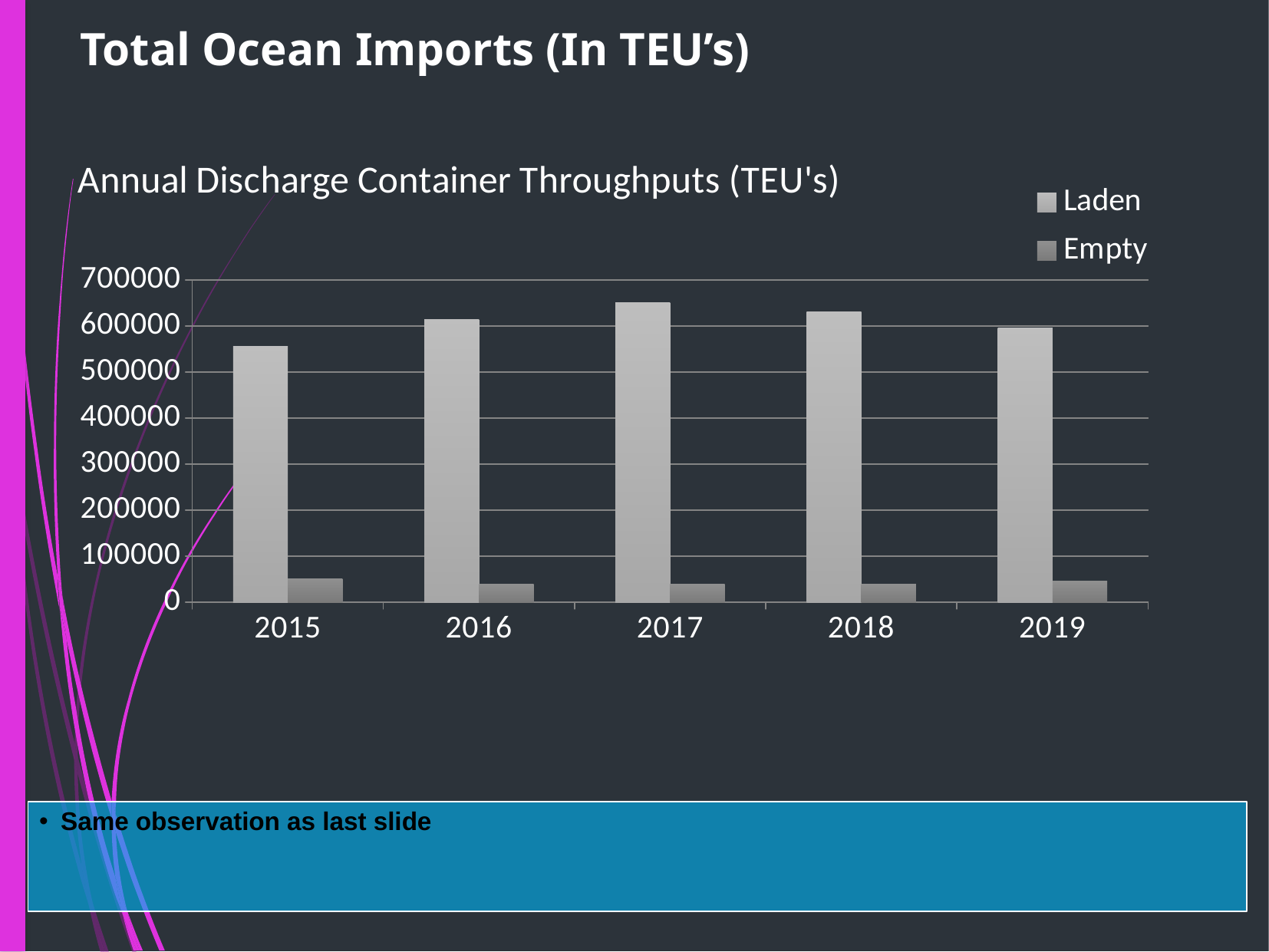
What is the title of the chart? Annual Discharge Container Throughputs (TEU's) What are the two series named in the chart legend? Laden and Empty Which is larger, the Laden value for 2016 or the Laden value for 2019? 2016 Which year has the highest Laden value? 2017 How many years are shown on the x axis of the chart? 5 Is the Empty value for 2016 greater or less than 100000? less Is the Laden value for 2017 greater or less than 600000? greater Which is larger in 2018, the Laden value or the Empty value? Laden How many series does the chart legend list? 2 What kind of chart is shown on the slide? bar chart Is the Laden value for 2015 greater or less than 600000? less Which year has the lowest Laden value? 2015